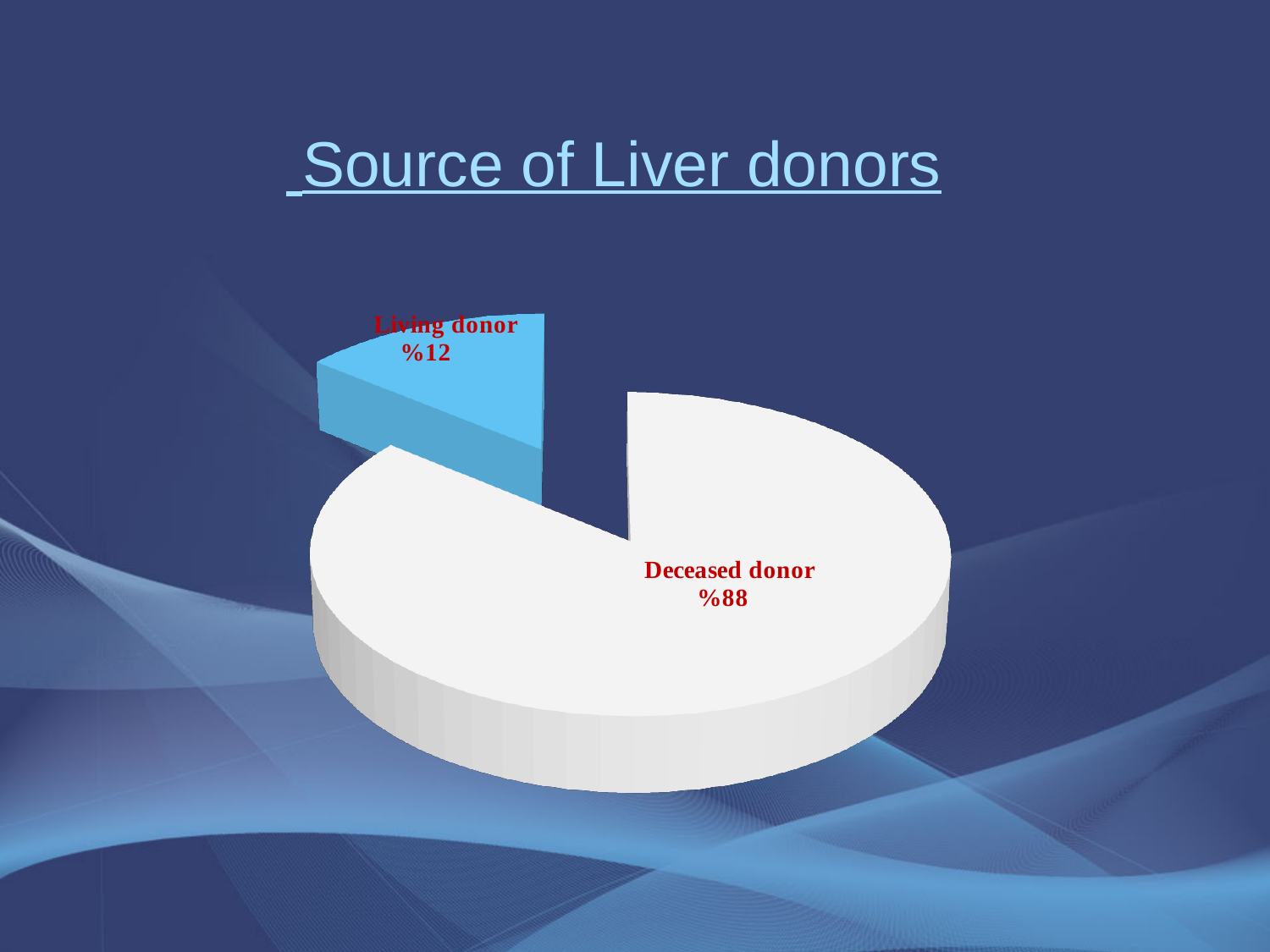
Which is larger, the Living donor slice or the Deceased donor slice? Deceased donor What is the title of the chart on the slide? Source of Liver donors What share of the pie is labelled for Living donor? %12 How many slices does the pie chart have? 2 What type of chart is shown on the slide? Pie chart Which slice of the pie is the smallest? Living donor What share of the pie is labelled for Deceased donor? %88 What is the difference in percentage points between the Deceased donor and Living donor slices? 76 What colour is the Living donor slice? Blue Which slice of the pie is the largest? Deceased donor